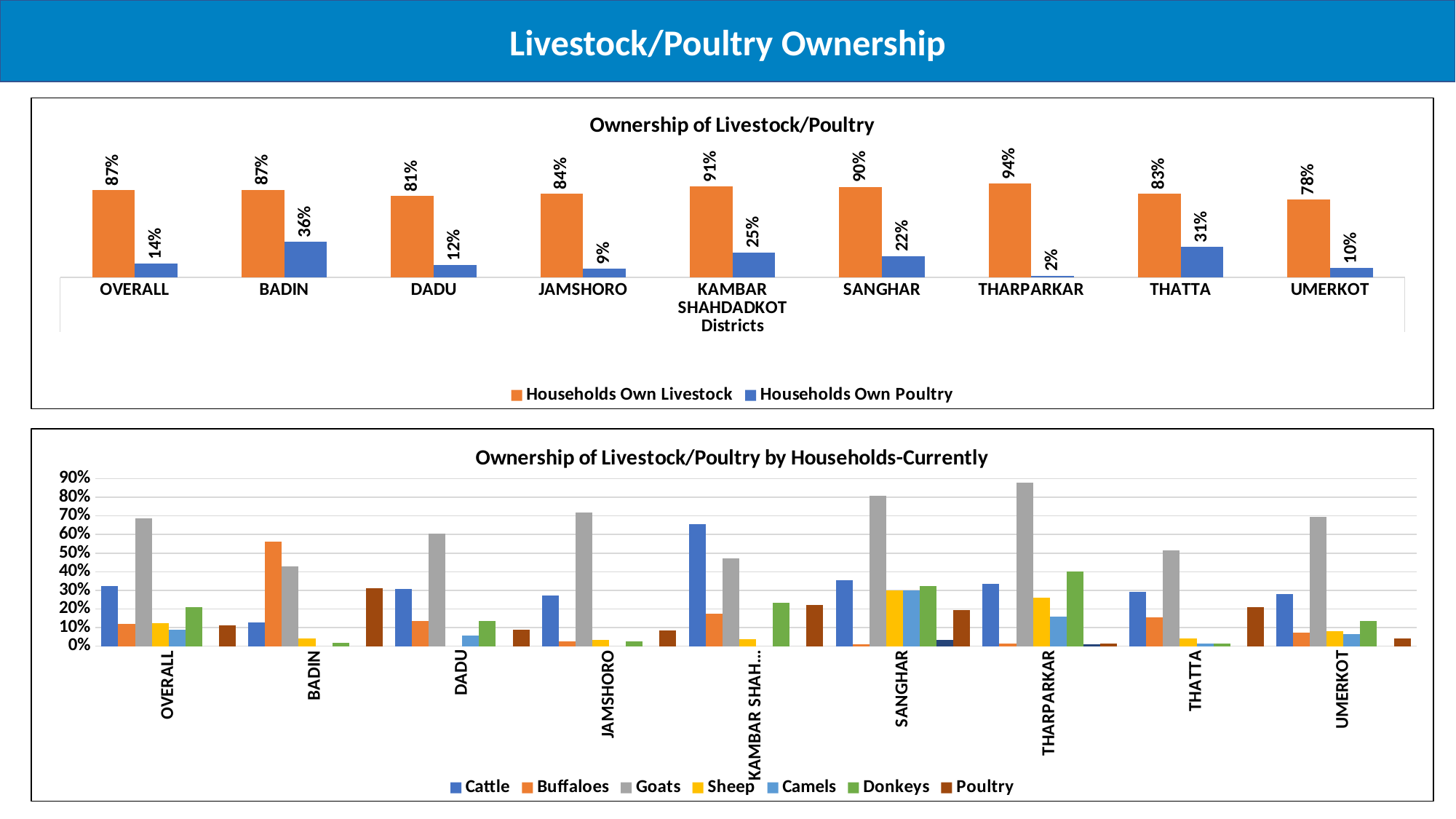
In the 'Ownership of Livestock/Poultry by Households-Currently' chart, is the value for Goats in Tharparkar greater or less than 80%? greater In the 'Ownership of Livestock/Poultry' chart, which district has the lowest share of households owning poultry? Tharparkar In the 'Ownership of Livestock/Poultry' chart, what is the difference between the livestock and poultry ownership percentages for Thatta? 52% How many series does the legend of the 'Ownership of Livestock/Poultry by Households-Currently' chart list? 7 In the 'Ownership of Livestock/Poultry' chart, what percentage of households in Badin own poultry? 36% In the 'Ownership of Livestock/Poultry by Households-Currently' chart, which colour represents Goats in the legend? Grey In the 'Ownership of Livestock/Poultry' chart, which is larger: poultry ownership in Kambar Shahdadkot or in Sanghar? Kambar Shahdadkot In the 'Ownership of Livestock/Poultry' chart, which district has the lowest share of households owning livestock? Umerkot How many districts (including Overall) are shown on the x axis of the 'Ownership of Livestock/Poultry' chart? 9 What type of chart is the 'Ownership of Livestock/Poultry by Households-Currently' chart? Bar chart In the 'Ownership of Livestock/Poultry' chart, what percentage of households in Tharparkar own livestock? 94% In the 'Ownership of Livestock/Poultry by Households-Currently' chart, is the value for Cattle in Kambar Shahdadkot greater or less than 60%? greater